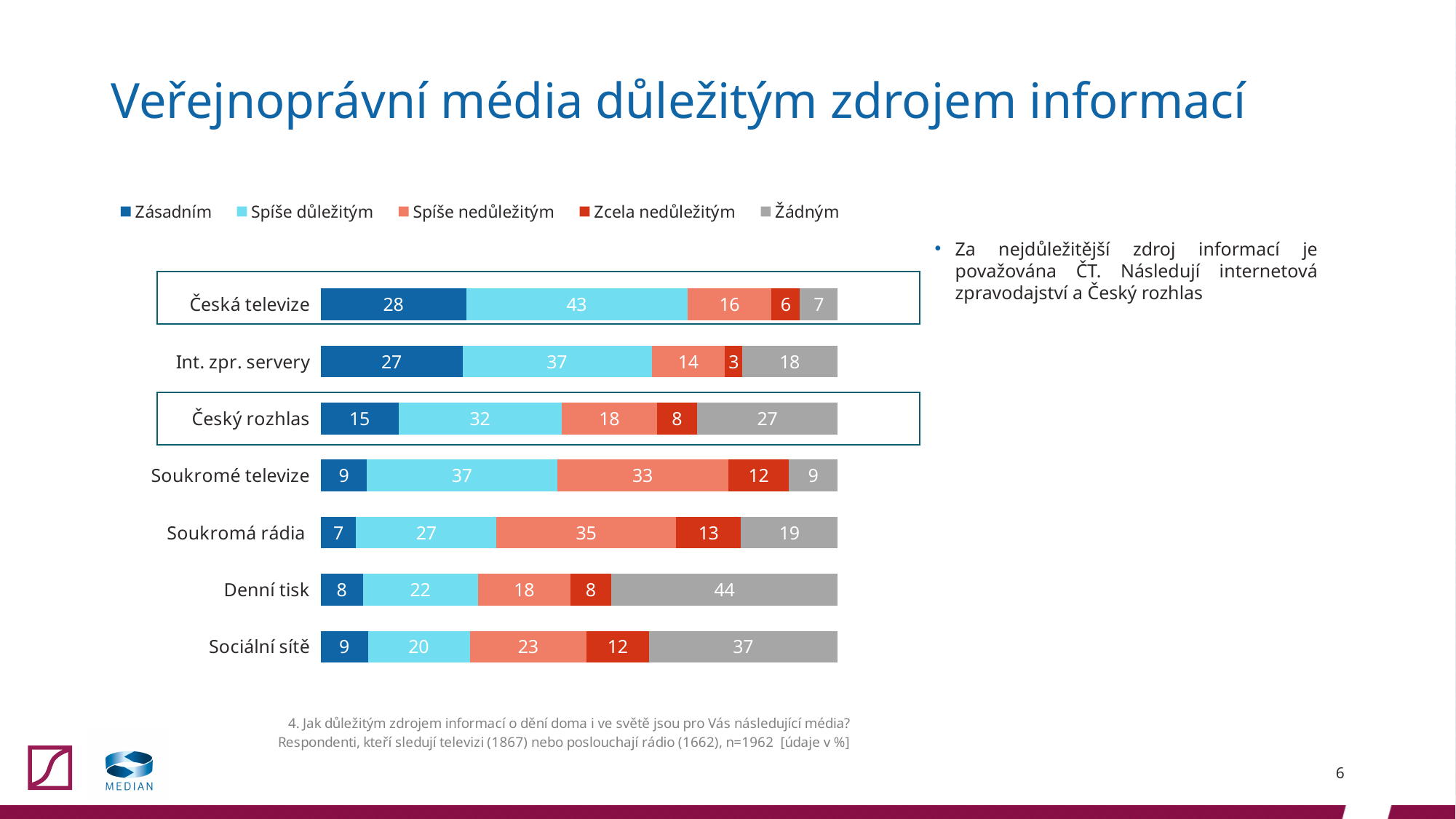
What is the value of "Zásadním" for Česká televize? 28 What is the difference between the "Spíše důležitým" values for Česká televize and Český rozhlas? 11 Which category has the lowest value for "Zásadním"? Soukromá rádia Which has a larger "Spíše nedůležitým" value, Soukromá rádia or Soukromé televize? Soukromá rádia How many series does the legend list? 5 How many categories (media types) are shown in the chart? 7 What is the value of "Žádným" for Denní tisk? 44 What is the value of "Zcela nedůležitým" for Int. zpr. servery? 3 Which category has the highest value for "Žádným"? Denní tisk What kind of chart is shown on the slide? Stacked bar chart What is the total of the stacked bar for Denní tisk? 100 What colour represents the "Žádným" series in the chart? Grey